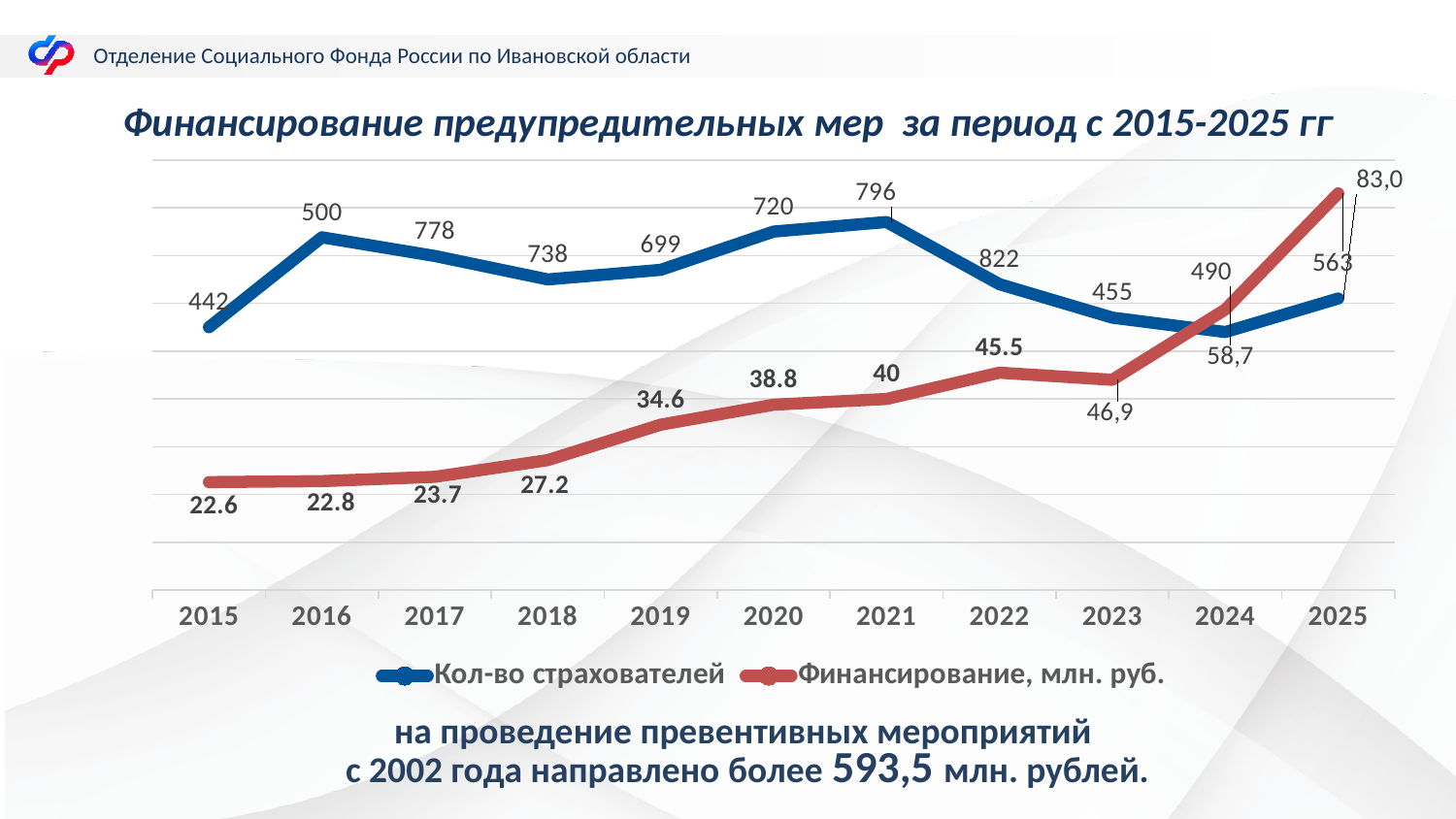
What is the value of Финансирование, млн. руб. for 2025? 83,0 What is the value of Кол-во страхователей for 2015? 442 What is the title of the chart? Финансирование предупредительных мер за период с 2015-2025 гг In which year is Финансирование, млн. руб. highest? 2025 What kind of chart is shown on the slide? line chart What is the difference between Финансирование, млн. руб. in 2022 and in 2021? 5.5 What is the value of Финансирование, млн. руб. for 2015? 22.6 How many years are shown on the x axis? 11 Does Финансирование, млн. руб. generally rise or fall from 2015 to 2025? rise How many series does the legend list? 2 What is the value of Финансирование, млн. руб. for 2019? 34.6 In which year is Финансирование, млн. руб. lowest? 2015